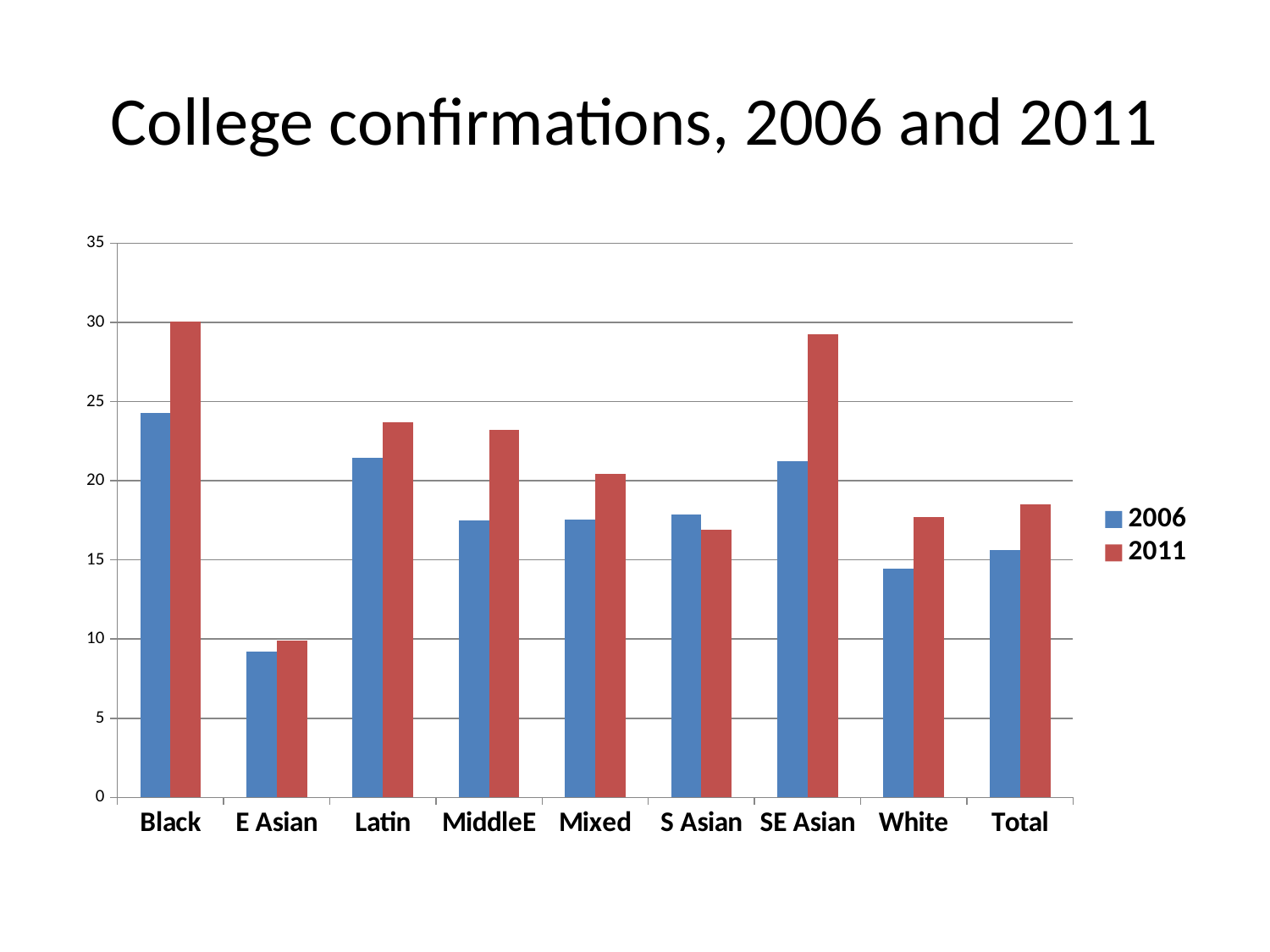
Is the 2011 value for SE Asian greater or less than 25? greater Which category has the highest 2006 value? Black For White, which is larger: the 2006 value or the 2011 value? 2011 What is the title of the chart? College confirmations, 2006 and 2011 How many series does the legend list? 2 How many categories are shown on the x axis? 9 Is the 2006 value for White greater or less than 15? less What kind of chart is shown on the slide? bar chart Which category has the lowest 2006 value? E Asian Which category has the lowest 2011 value? E Asian Is the 2006 value for Black greater or less than 20? greater